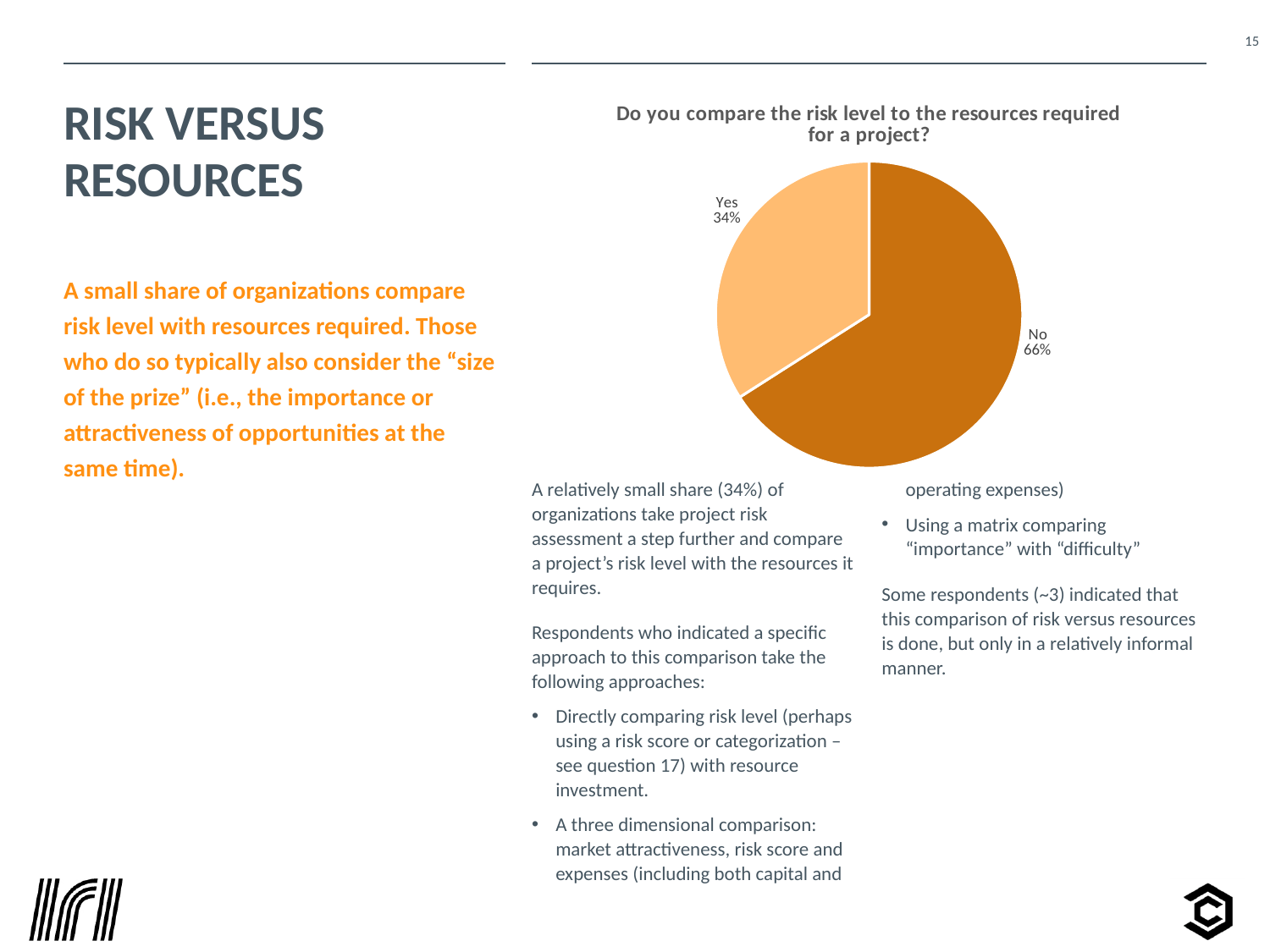
What share of the pie does the "Yes" slice represent? 34% Which response has the largest share of the pie? No Which response has the smallest share of the pie? Yes Which is larger, the share for "Yes" or the share for "No"? No What is the title of the chart? Do you compare the risk level to the resources required for a project? Which slice is shown in the darker orange colour? No What is the difference in percentage points between the "No" and "Yes" shares? 32 What percentage of respondents answered "No"? 66% What kind of chart is shown on the slide? pie chart What percentage of respondents answered "Yes"? 34% How many slices does the pie chart have? 2